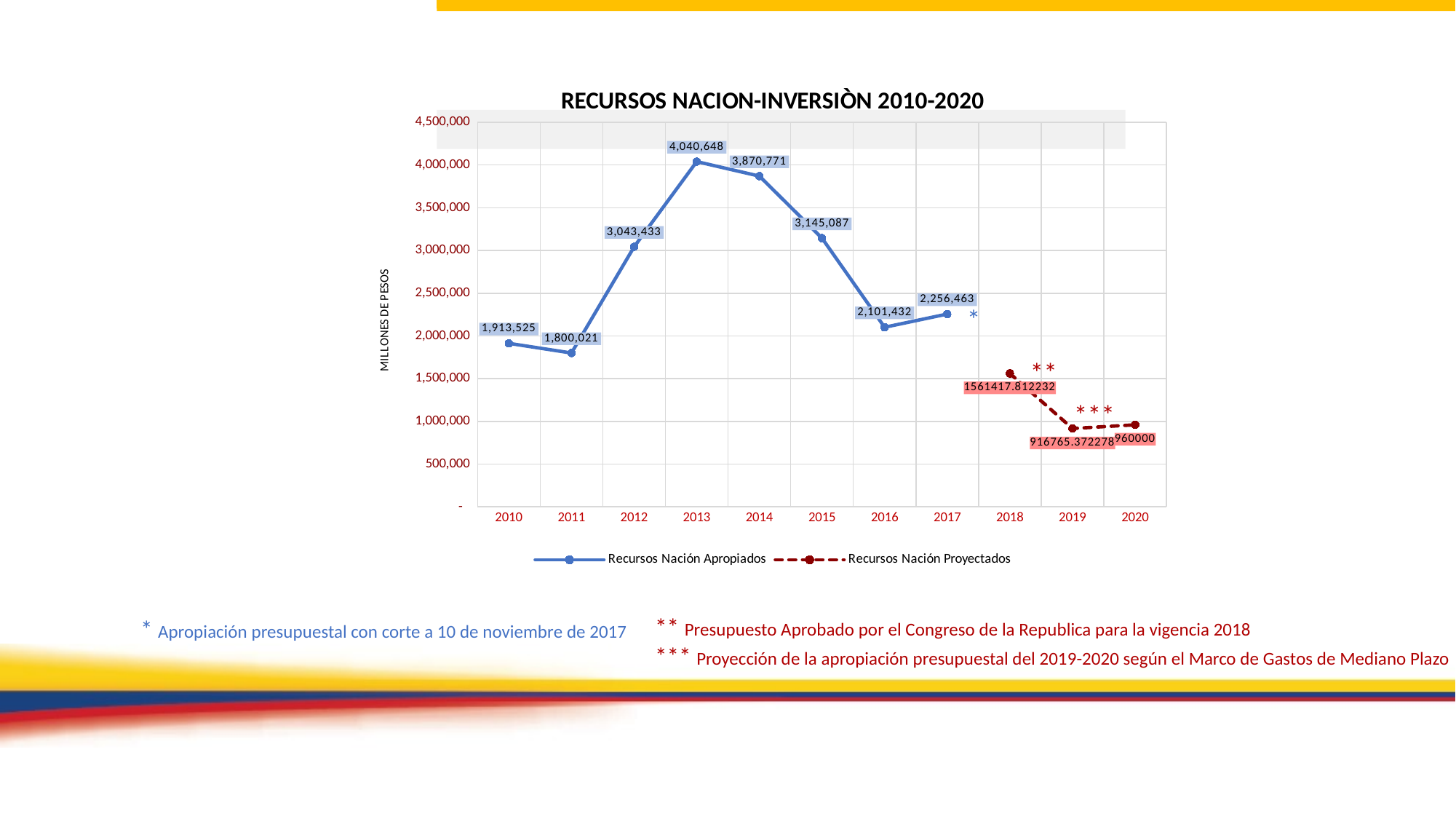
Do the Recursos Nación Apropiados values rise or fall from 2013 to 2016? fall What is the value for Recursos Nación Apropiados in 2013? 4,040,648 How many years are shown on the x axis of the chart? 11 In which year does the Recursos Nación Apropiados series have its lowest value? 2011 What is the projected value (Recursos Nación Proyectados) for 2020? 960000 What kind of chart is shown on the slide? line chart What is the difference between the 2013 and 2014 values of Recursos Nación Apropiados? 169,877 How many series does the legend list? 2 Is the projected value for 2019 greater or less than 1,000,000? less In which year does the Recursos Nación Apropiados series reach its highest value? 2013 What is the value for Recursos Nación Apropiados in 2011? 1,800,021 Which year has the larger value for Recursos Nación Apropiados, 2012 or 2015? 2015